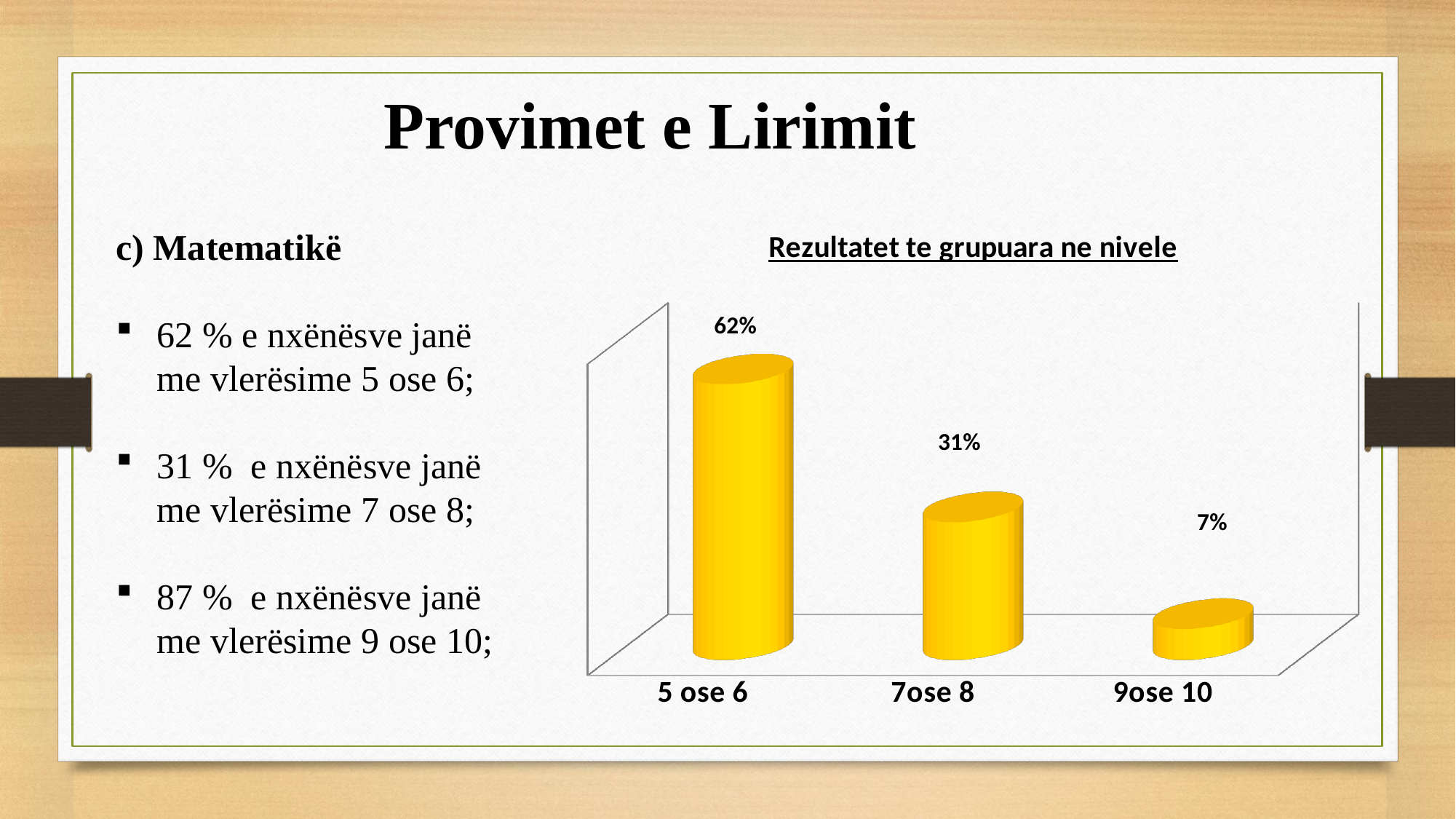
What is the value for the "5 ose 6" category? 62% What is the difference between the values for "5 ose 6" and "7ose 8"? 31% What kind of chart is shown on the slide? Bar chart What is the value for the "7ose 8" category? 31% What is the title of the chart? Rezultatet te grupuara ne nivele Do the values rise or fall from left to right along the x axis? Fall What is the value for the "9ose 10" category? 7% Which category has the highest value? 5 ose 6 Which is larger, the value for "7ose 8" or the value for "9ose 10"? 7ose 8 Which category has the lowest value? 9ose 10 What is the difference between the values for "7ose 8" and "9ose 10"? 24% How many categories are shown on the chart? 3